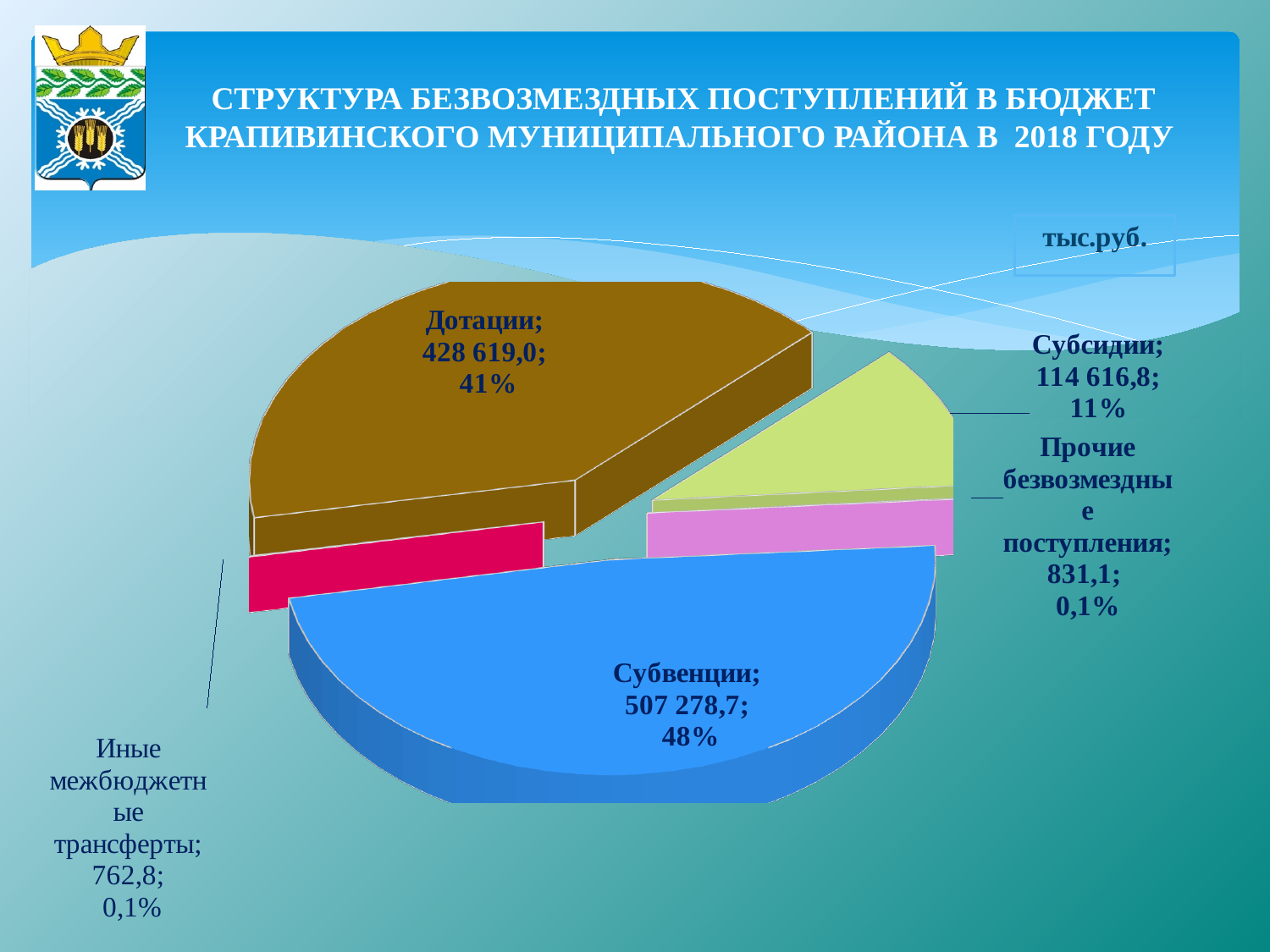
Which category has the smallest value? Иные межбюджетные трансферты What is the value for Дотации? 428 619,0 Which category has the largest value? Субвенции What kind of chart is shown on the slide? pie chart What is the difference between the values for Субвенции and Дотации? 78 659,7 How many slices does the pie chart have? 5 What is the value for Иные межбюджетные трансферты? 762,8 What unit is indicated for the values on the chart? тыс.руб. What is the value for Субвенции? 507 278,7 What share of the pie does Прочие безвозмездные поступления represent? 0,1% What is the value for Субсидии? 114 616,8 What share of the pie does Субсидии represent? 11%